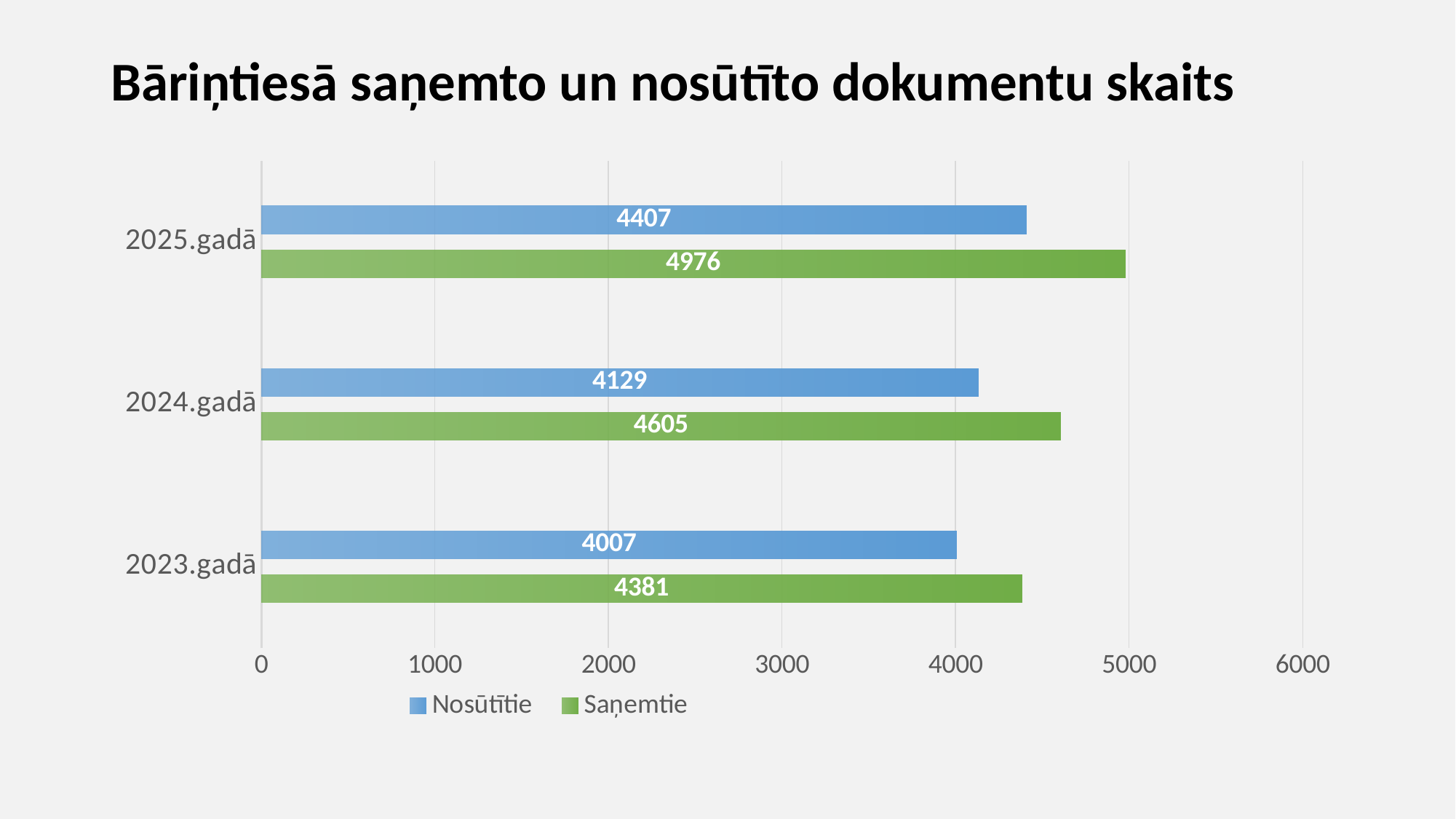
What is the Nosūtītie value for 2025.gadā? 4407 How many years are shown on the chart? 3 What kind of chart is shown on the slide? bar chart What is the difference between Saņemtie and Nosūtītie in 2025.gadā? 569 What is the Saņemtie value for 2023.gadā? 4381 How many series does the legend list? 2 Which is larger in 2024.gadā, Nosūtītie or Saņemtie? Saņemtie Which year has the highest Saņemtie value? 2025.gadā What is the Saņemtie value for 2024.gadā? 4605 What is the difference between the Nosūtītie values for 2024.gadā and 2023.gadā? 122 Is the Saņemtie value for 2025.gadā greater or less than 5000? less Which year has the lowest Nosūtītie value? 2023.gadā